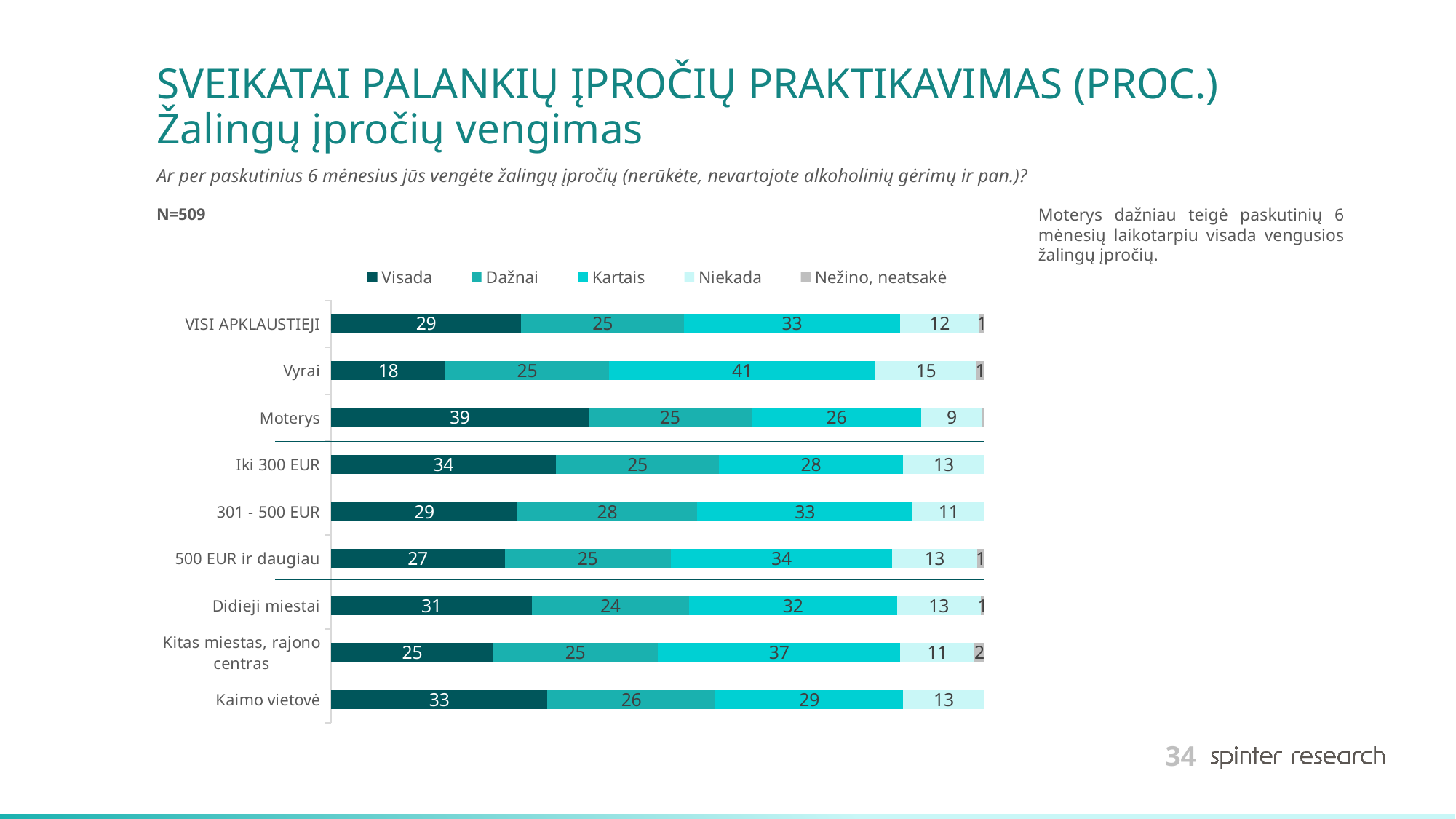
What is the 'Visada' value for Moterys? 39 Which category has the highest 'Visada' value? Moterys How many series does the legend list? 5 What is the 'Nežino, neatsakė' value for Kitas miestas, rajono centras? 2 How many categories are plotted on the chart? 9 Which has the larger 'Kartais' value, Vyrai or Moterys? Vyrai What is the difference between the 'Visada' values for Moterys and Vyrai? 21 What is the 'Kartais' value for Vyrai? 41 What type of chart is shown on the slide? Stacked bar chart Which category has the lowest 'Visada' value? Vyrai What is the total of the stacked bar for Vyrai? 100 What is the 'Niekada' value for VISI APKLAUSTIEJI? 12